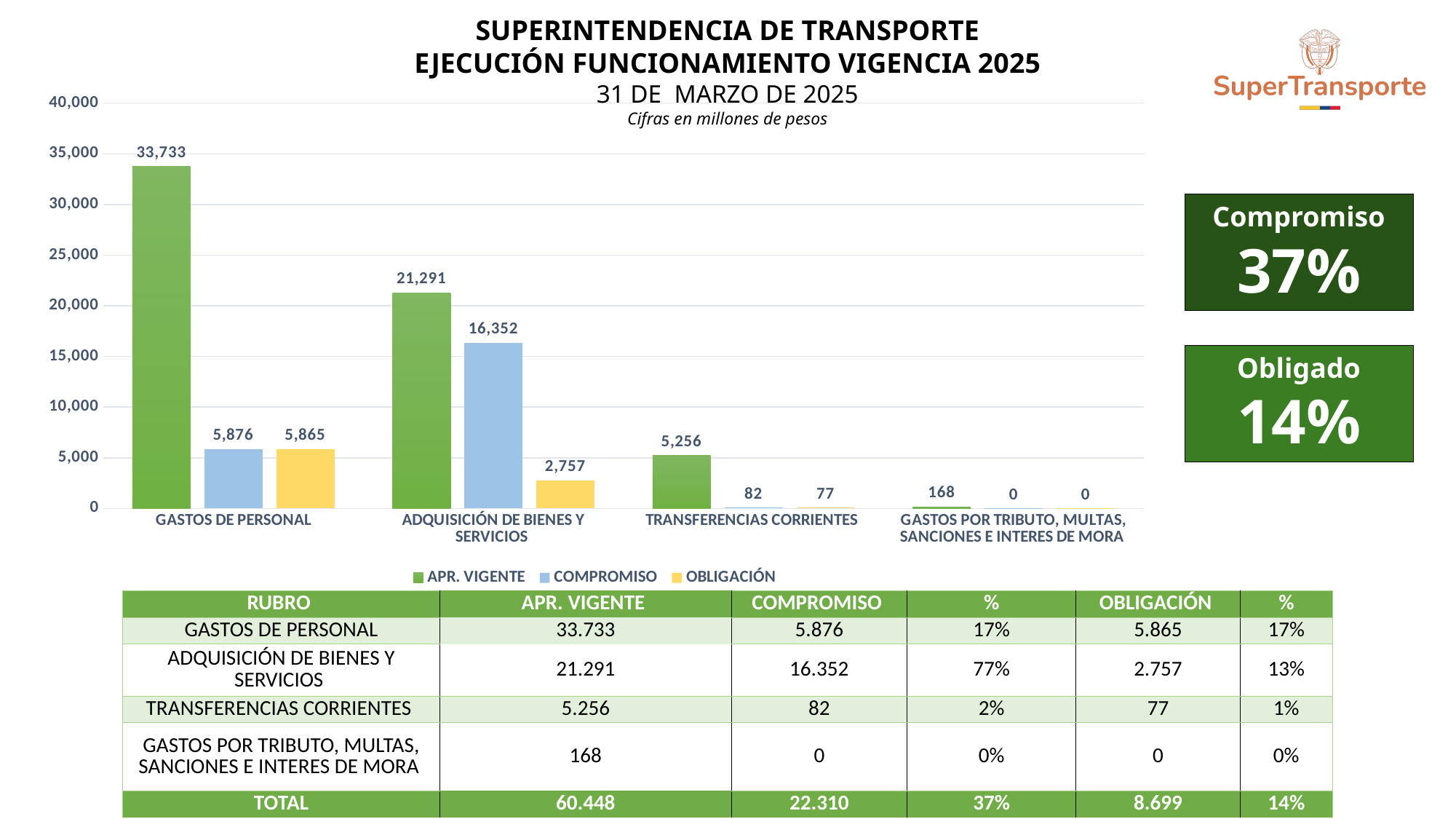
What is the difference between the APR. VIGENTE and COMPROMISO values for GASTOS DE PERSONAL? 27,857 Which colour represents the OBLIGACIÓN series in the chart? Yellow Which category has the lowest APR. VIGENTE value? GASTOS POR TRIBUTO, MULTAS, SANCIONES E INTERES DE MORA Which is larger for ADQUISICIÓN DE BIENES Y SERVICIOS: COMPROMISO or OBLIGACIÓN? COMPROMISO What is the APR. VIGENTE value for GASTOS DE PERSONAL? 33,733 What kind of chart is shown on the slide? Bar chart How many categories are shown on the x axis of the chart? 4 What is the OBLIGACIÓN value for TRANSFERENCIAS CORRIENTES? 77 How many series does the chart legend list? 3 Is the APR. VIGENTE value for ADQUISICIÓN DE BIENES Y SERVICIOS greater or less than 20,000? greater Which category has the highest APR. VIGENTE value? GASTOS DE PERSONAL What is the COMPROMISO value for ADQUISICIÓN DE BIENES Y SERVICIOS? 16,352